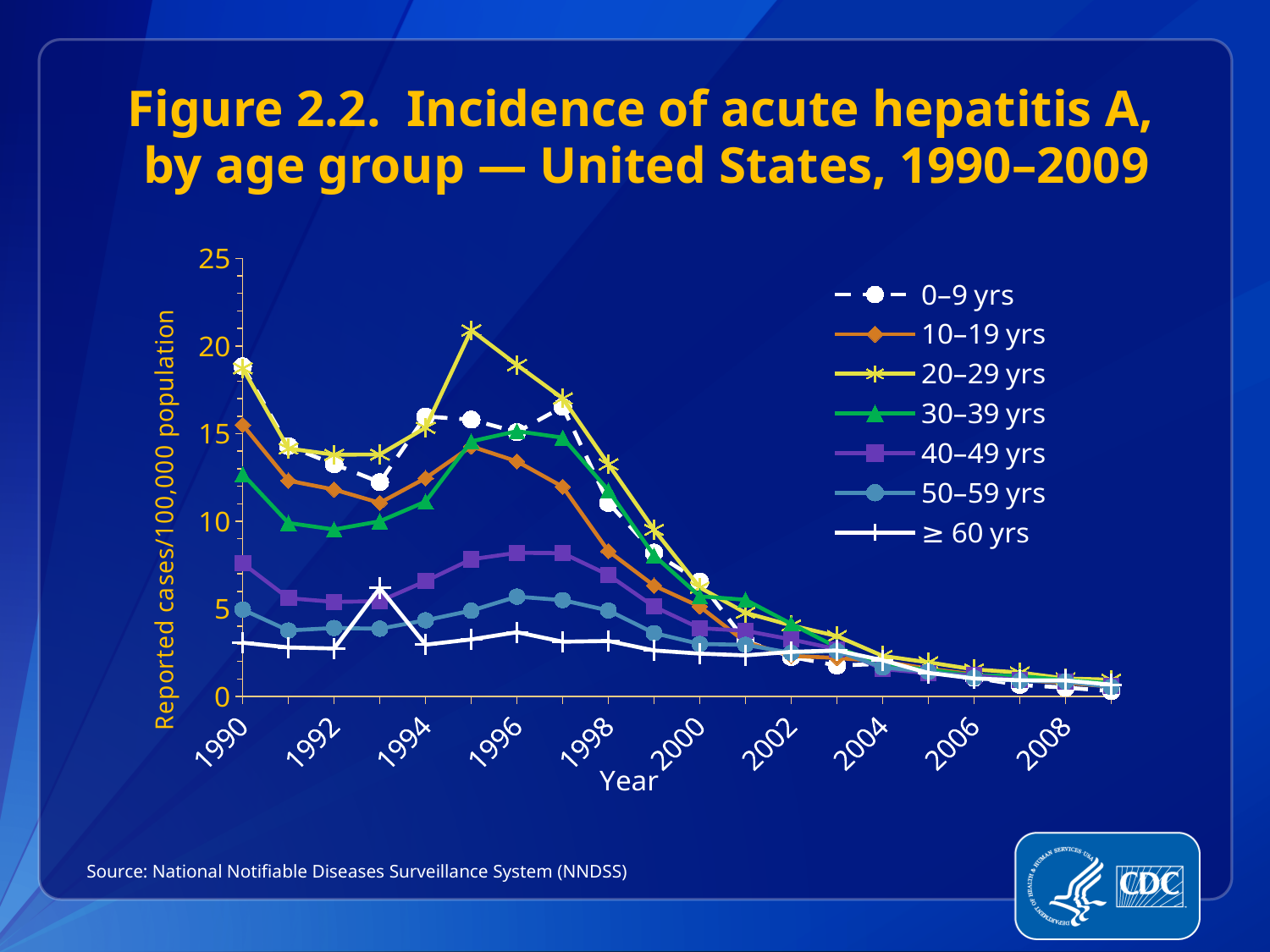
Is the value for the 40–49 yrs group in 1990 greater or less than 10? less Is the value for the 20–29 yrs group in 1990 greater or less than 15? greater Which age group is drawn with the white dashed line and circle markers? 0–9 yrs Which age group has the lowest incidence in 1990? ≥ 60 yrs Overall, do the incidence values rise or fall from 1990 to 2009? Fall Is the value for the ≥ 60 yrs group in 1993 greater or less than 5? greater What kind of chart is shown on the slide? Line chart How many age-group series does the legend list? 7 What is the label on the y axis? Reported cases/100,000 population In 1995, which is larger: the value for the 20–29 yrs group or the 30–39 yrs group? 20–29 yrs